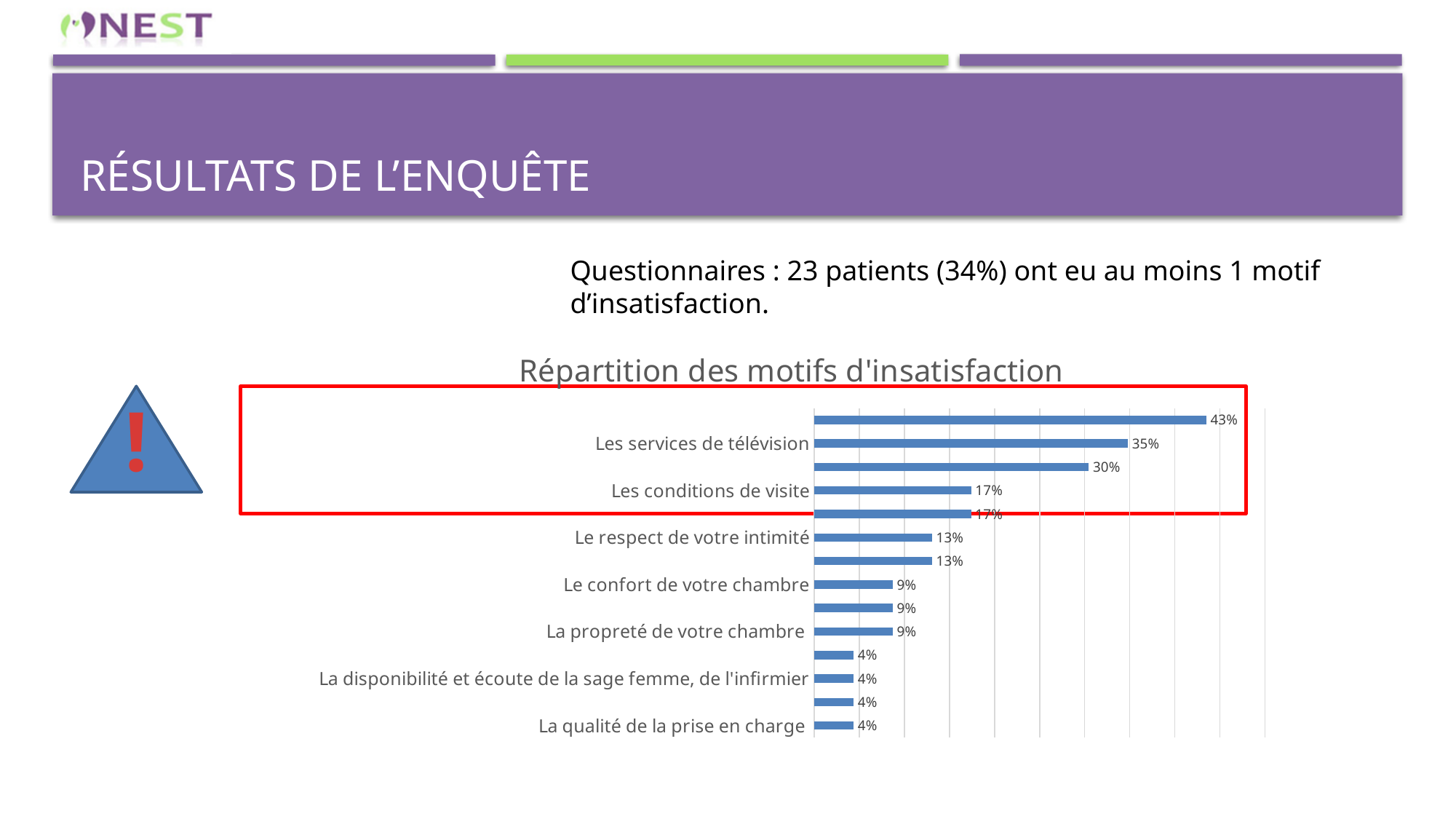
What kind of chart is shown on the slide? Bar chart What is the difference between the values for 'Les services de télévision' and 'Les conditions de visite'? 18% What is the value for 'Les conditions de visite'? 17% What is the value for 'Le confort de votre chambre'? 9% How many bars are plotted on the chart? 14 What is the largest value shown on the chart? 43% Which is larger: the value for 'Le respect de votre intimité' or for 'La propreté de votre chambre'? Le respect de votre intimité What is the value for 'Le respect de votre intimité'? 13% What is the value for 'La disponibilité et écoute de la sage femme, de l'infirmier'? 4% What is the value for 'Les services de télévision'? 35% What is the value for 'La qualité de la prise en charge'? 4% What is the title of the chart? Répartition des motifs d'insatisfaction